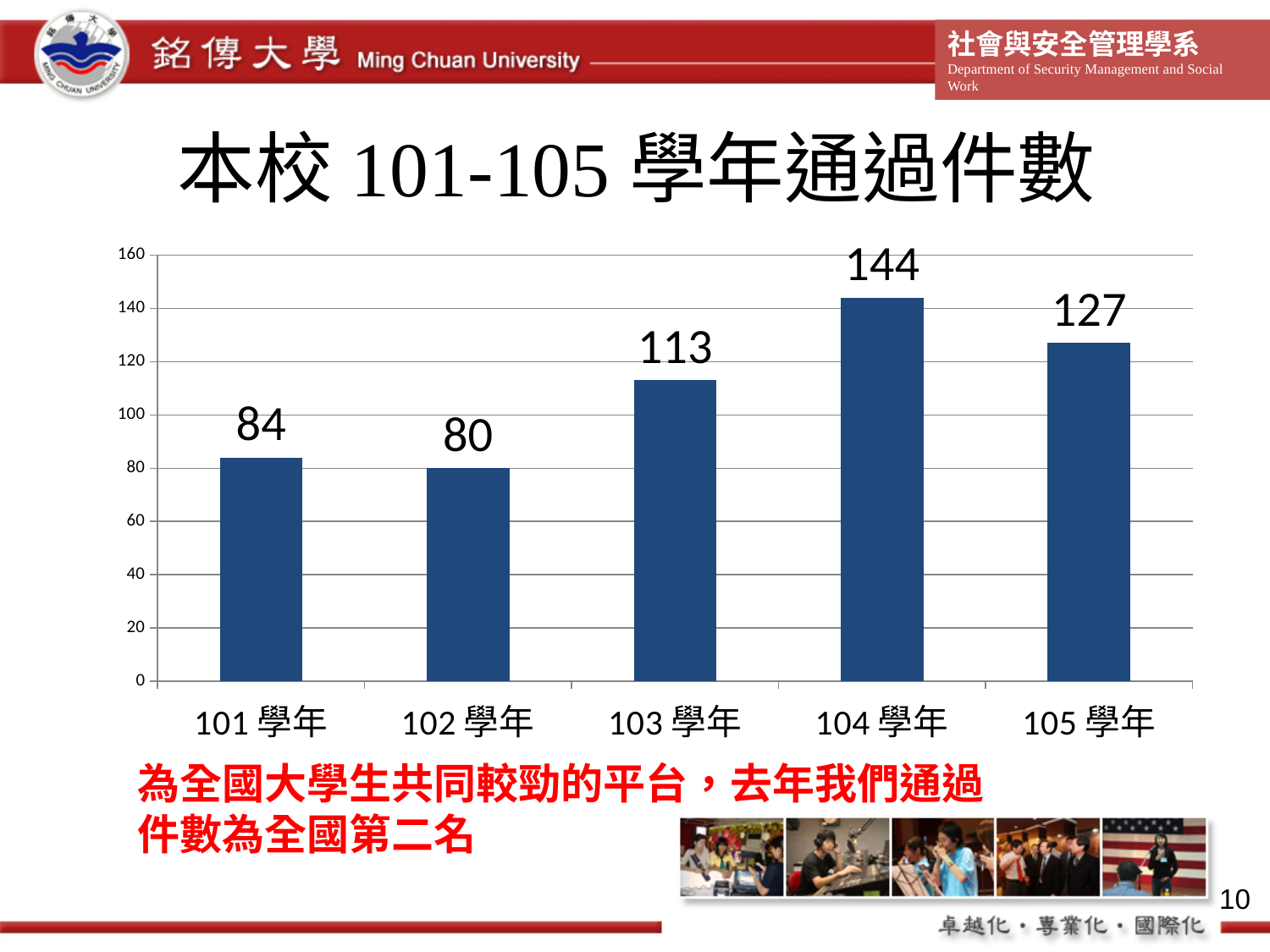
What is the value for 105 學年? 127 How many academic years are shown on the x axis? 5 What kind of chart is shown on the slide? bar chart Which academic year has the lowest value? 102 學年 What is the value for 103 學年? 113 Which academic year has the highest value? 104 學年 Is the value for 104 學年 greater or less than 140? greater What is the difference between the values for 104 學年 and 105 學年? 17 Which is larger, the value for 101 學年 or 102 學年? 101 學年 What is the title of the chart? 本校 101-105 學年通過件數 What is the value for 101 學年? 84 What is the difference between the values for 103 學年 and 102 學年? 33